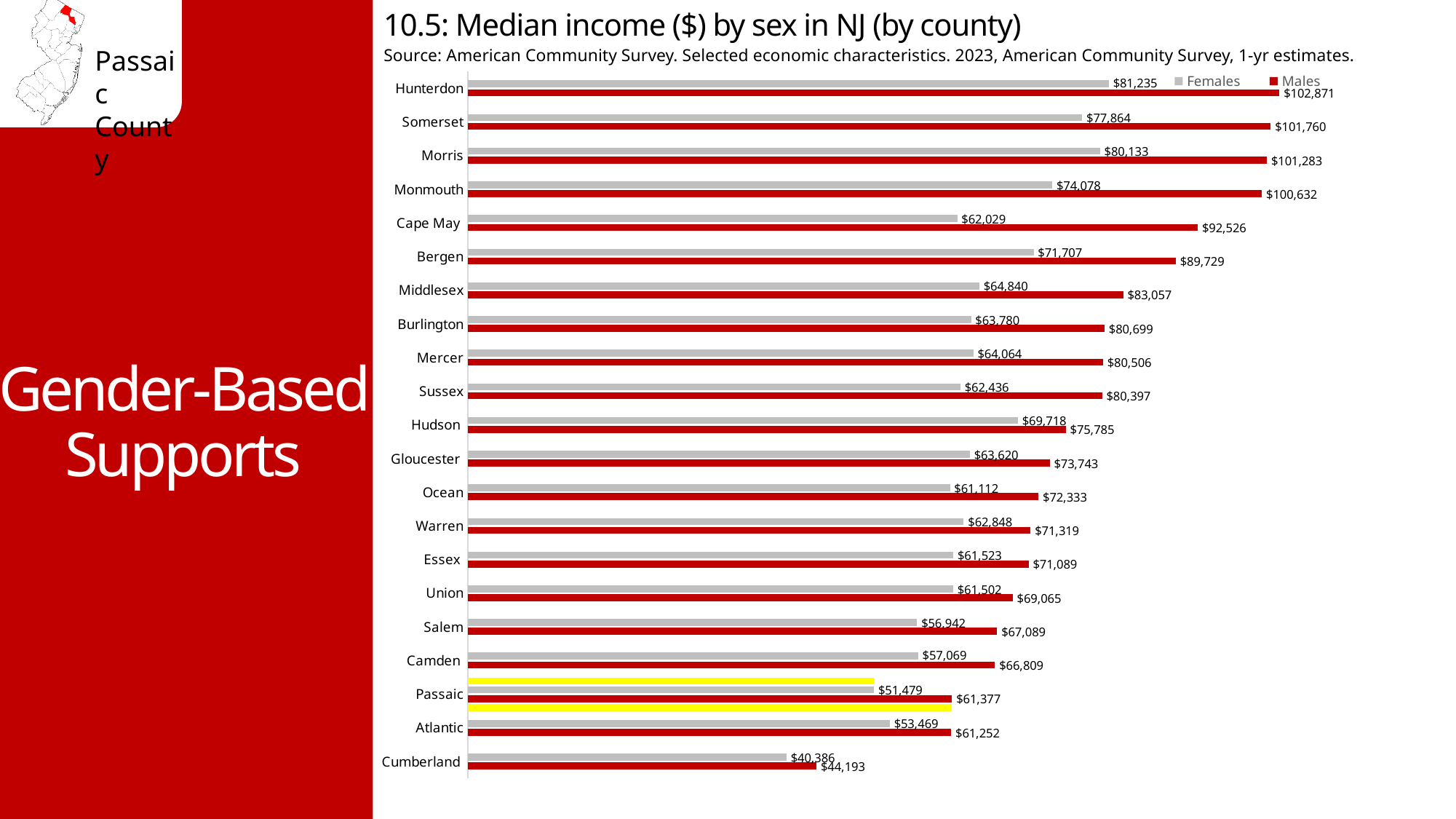
What is the median income for males in Hunterdon County? $102,871 What is the median income for females in Passaic County? $51,479 What is the difference between male and female median income in Hunterdon County? $21,636 How many counties are shown in the chart? 21 What is the median income for females in Cumberland County? $40,386 How many series does the legend list? 2 Which is larger, the female median income in Hudson County or in Bergen County? Bergen County What is the median income for males in Passaic County? $61,377 Which county has the lowest median income for females? Cumberland What is the difference between male and female median income in Passaic County? $9,898 What kind of chart is shown on the slide? Bar chart Which county has the highest median income for males? Hunterdon